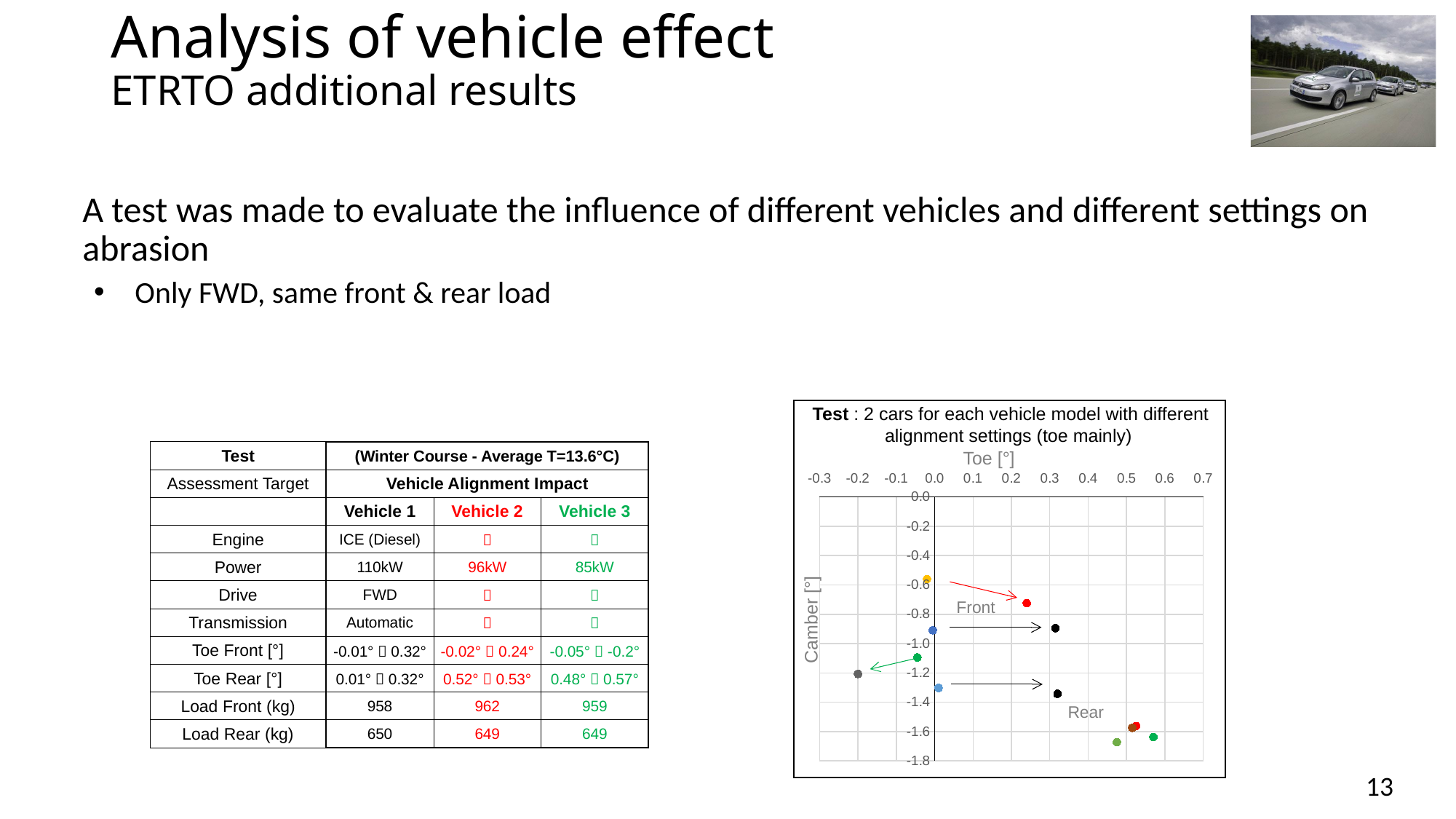
What kind of chart is shown on the slide? scatter chart Is the toe value of the rightmost Rear point greater or less than 0.5? greater Are the camber values of the Rear points greater or less than -1.0? less What are the x-axis and y-axis titles of the chart? Toe [°] and Camber [°] Is the toe value of the leftmost point on the chart greater or less than -0.1? less What is the title of the chart on the slide? Test : 2 cars for each vehicle model with different alignment settings (toe mainly) Which group of points, Front or Rear, has the more negative camber values on the chart? Rear